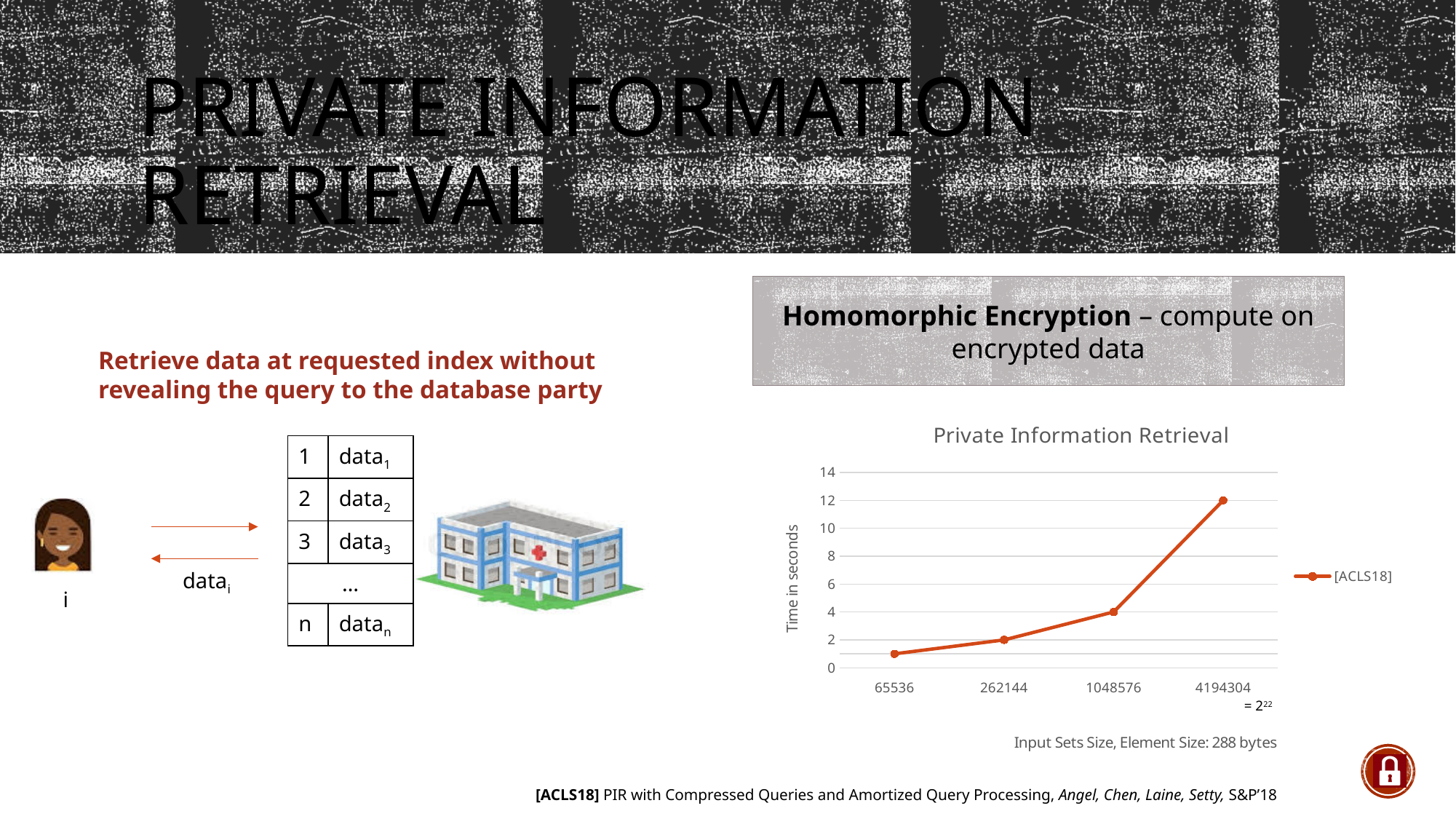
What kind of chart is shown on the slide? line chart What is the difference in time between input set sizes 4194304 and 1048576? 8 How many data points are plotted on the chart? 4 Which input set size has the lowest time in seconds? 65536 What is the time in seconds for an input set size of 4194304? 12 What is the time in seconds for an input set size of 262144? 2 Is the time for an input set size of 65536 greater or less than 2 seconds? less How many series does the chart legend list? 1 Which input set size has the highest time in seconds? 4194304 What is the time in seconds for an input set size of 1048576? 4 What is the title of the chart? Private Information Retrieval What is the name of the series in the chart legend? [ACLS18]